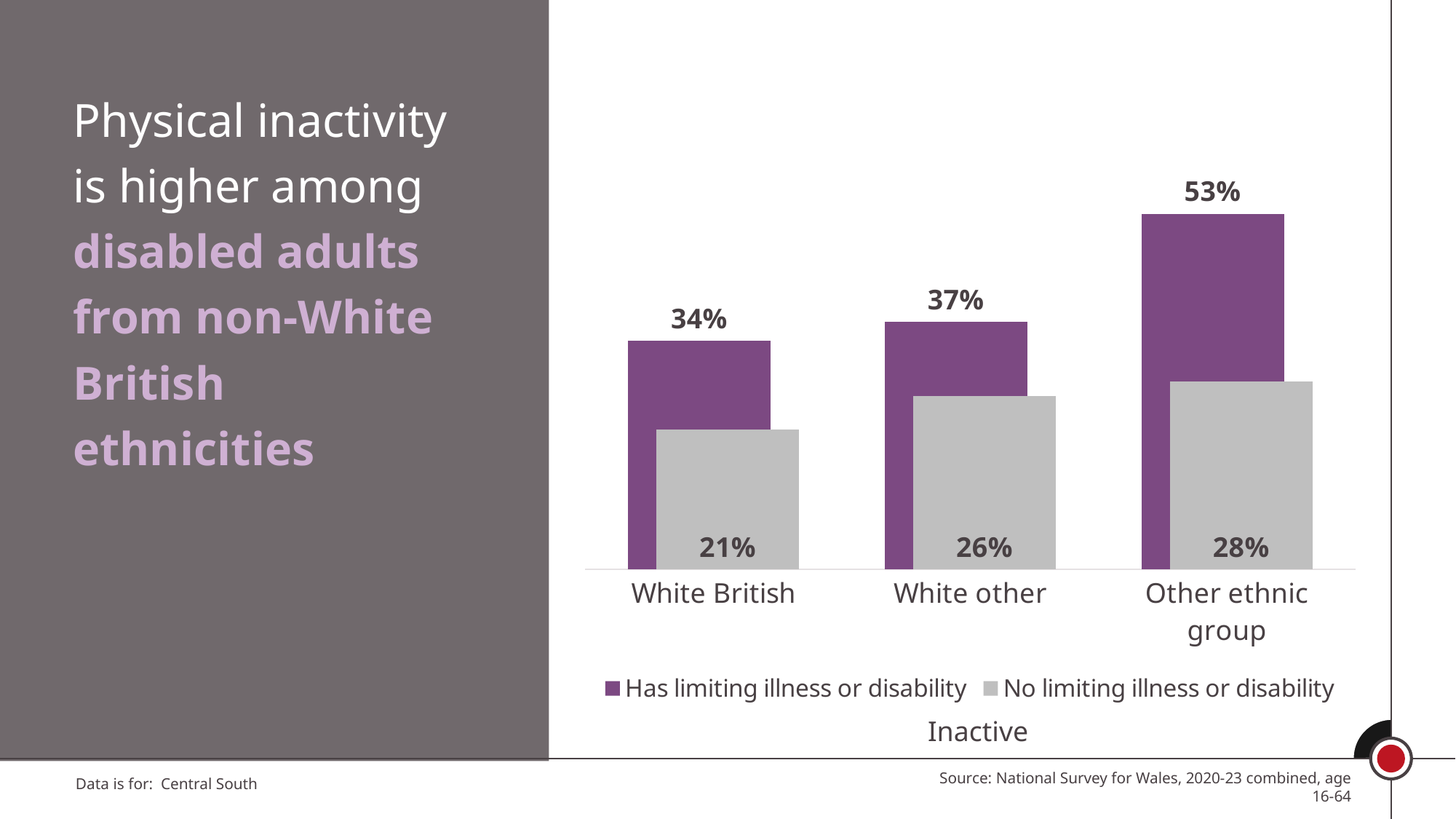
Which ethnic group has the highest inactivity value among those with a limiting illness or disability? Other ethnic group How many series does the legend list? 2 Do the 'Has limiting illness or disability' values rise or fall from White British to Other ethnic group? Rise How many ethnic group categories are shown on the x axis? 3 What is the value for Other ethnic group adults with no limiting illness or disability? 28% What is the difference between the 'Has limiting illness or disability' values for White other and White British? 3% Which is larger: the 'No limiting illness or disability' value for White other or for White British? White other What is the difference between the 'Has limiting illness or disability' and 'No limiting illness or disability' values for Other ethnic group? 25% What kind of chart is shown on the slide? Bar chart Which ethnic group has the lowest inactivity value among those with no limiting illness or disability? White British What is the value for White British adults who have a limiting illness or disability? 34% What is the value for White other adults who have a limiting illness or disability? 37%